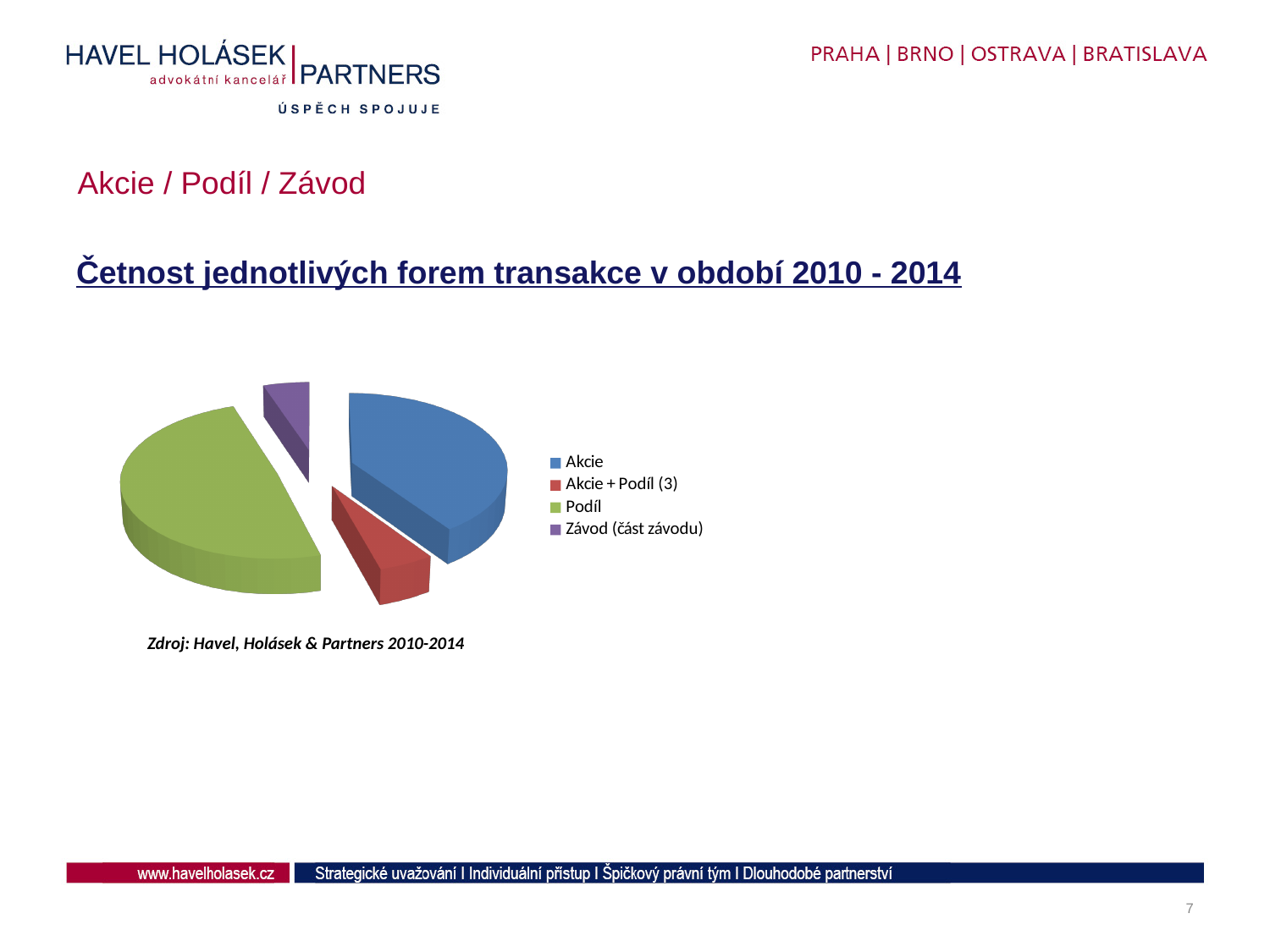
How many entries does the legend of the pie chart list? 4 Which category has the largest slice in the pie chart? Podíl Which slice is larger, Akcie or Akcie + Podíl (3)? Akcie What is the title of the chart on the slide? Četnost jednotlivých forem transakce v období 2010 - 2014 Which slice is larger, Akcie or Závod (část závodu)? Akcie Which slice is larger, Podíl or Akcie? Podíl What colour is the Podíl slice in the pie chart? Green How many slices does the pie chart have? 4 What kind of chart is shown on the slide? Pie chart